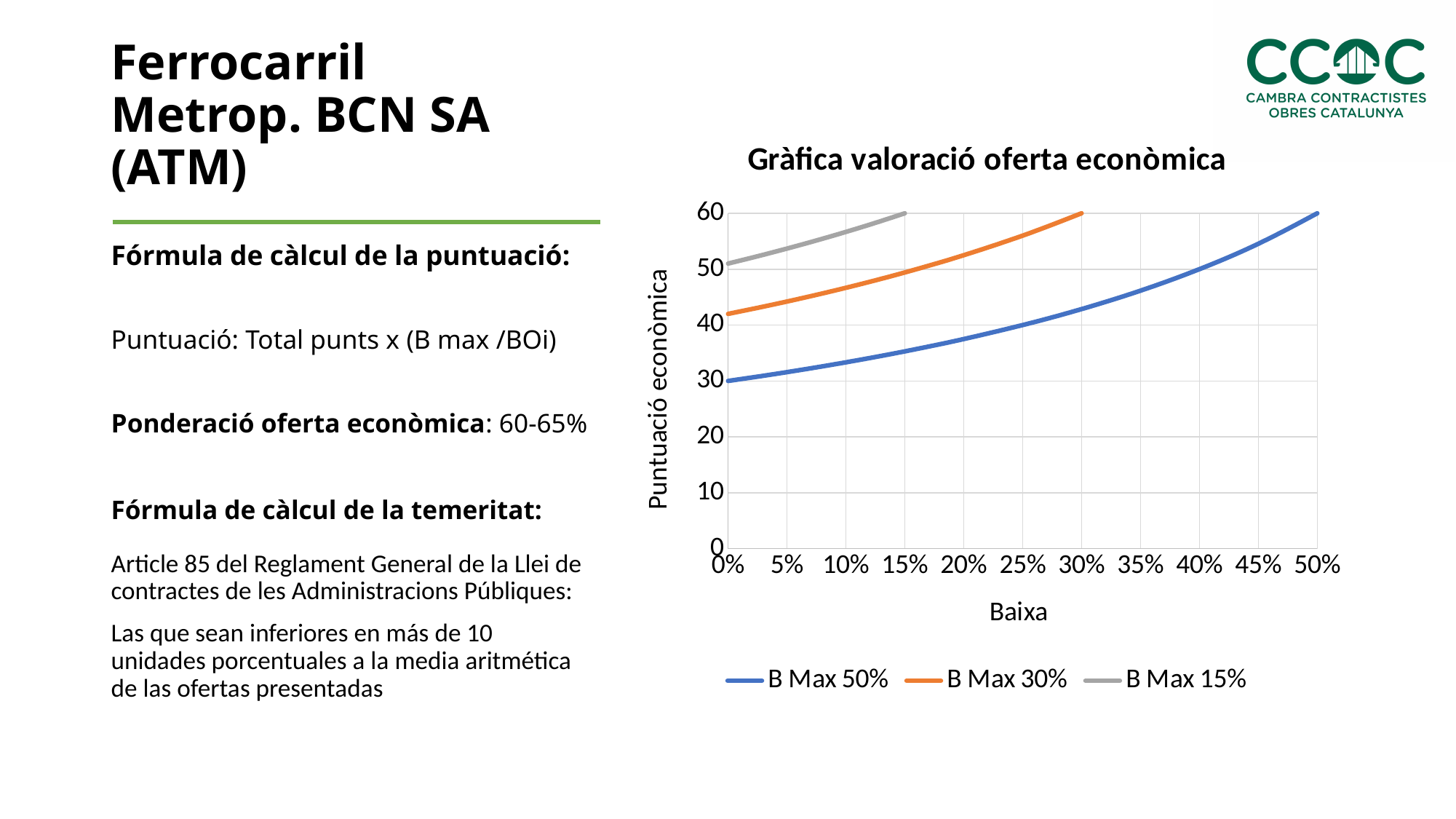
What is the title of the chart? Gràfica valoració oferta econòmica At what Baixa does the B Max 15% series reach a Puntuació econòmica of 60? 15% How many series does the legend of the chart list? 3 Is the value for the B Max 30% series at a Baixa of 0% greater or less than 50? less Is the value for the B Max 50% series at a Baixa of 25% greater or less than 50? less What is the Puntuació econòmica for the B Max 50% series at a Baixa of 0%? 30 Is the value for the B Max 15% series at a Baixa of 0% greater or less than 40? greater Does the B Max 50% series rise or fall as Baixa increases? rises What is the Puntuació econòmica for the B Max 50% series at a Baixa of 50%? 60 What kind of chart is shown on the slide? line chart At a Baixa of 10%, which series has the higher Puntuació econòmica, B Max 15% or B Max 50%? B Max 15% At what Baixa does the B Max 30% series reach a Puntuació econòmica of 60? 30%